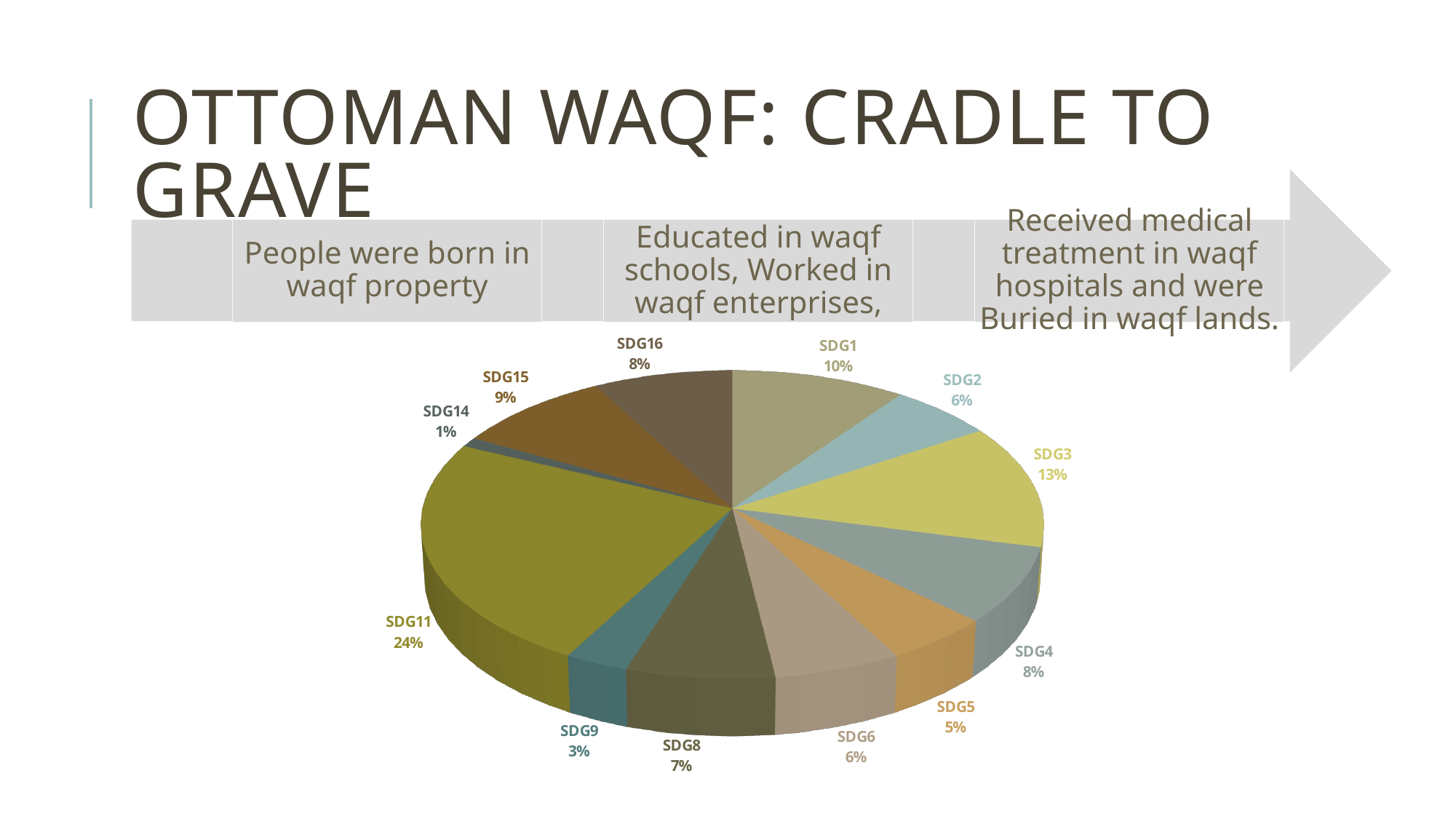
What share of the pie does SDG11 represent? 24% What is the value shown for SDG14? 1% Which is larger, the value for SDG1 or the value for SDG15? SDG1 What kind of chart is shown on the slide? pie chart Which two slices both show a value of 6%? SDG2 and SDG6 Which slice of the pie is the smallest? SDG14 Which slice of the pie is the largest? SDG11 What is the value shown for SDG16? 8% What is the value shown for SDG3? 13% What is the difference between the values for SDG11 and SDG3? 11% How many slices does the pie chart have? 12 What is the difference between the values for SDG8 and SDG9? 4%